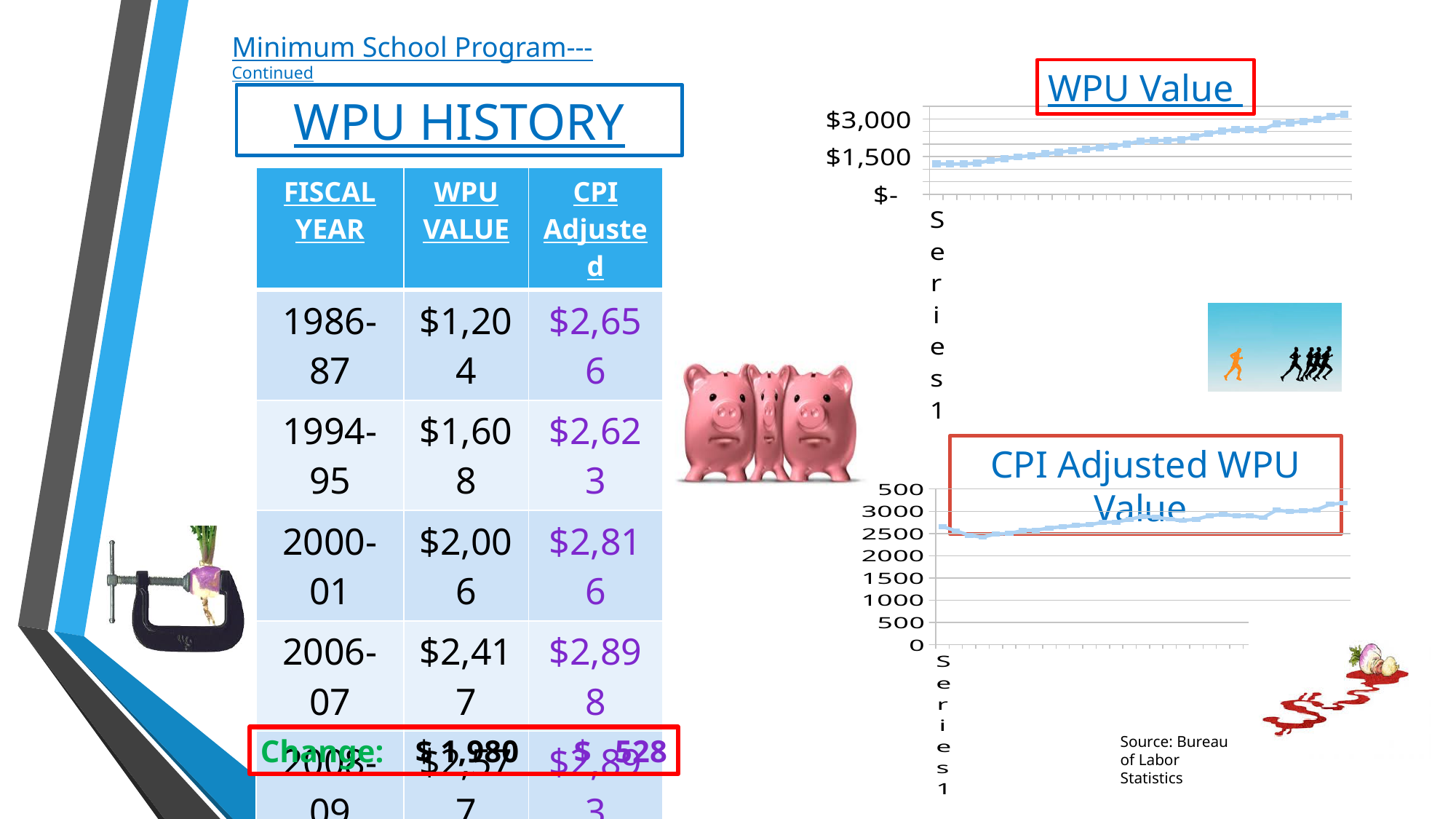
In the "CPI Adjusted WPU Value" chart, is the first (leftmost) point greater or less than 2000? greater What is the title of the top-right chart on the slide? WPU Value In the "WPU Value" chart, do the values rise or fall from left to right along the x axis? rise In the "CPI Adjusted WPU Value" chart, is the last (rightmost) point greater or less than 3000? greater What kind of chart is the "WPU Value" chart? line chart In the "WPU Value" chart, is the first (leftmost) point greater or less than $1,500? less What is the title of the bottom-right chart on the slide? CPI Adjusted WPU Value What kind of chart is the "CPI Adjusted WPU Value" chart? line chart In the "CPI Adjusted WPU Value" chart, do the values overall rise or fall from left to right? rise